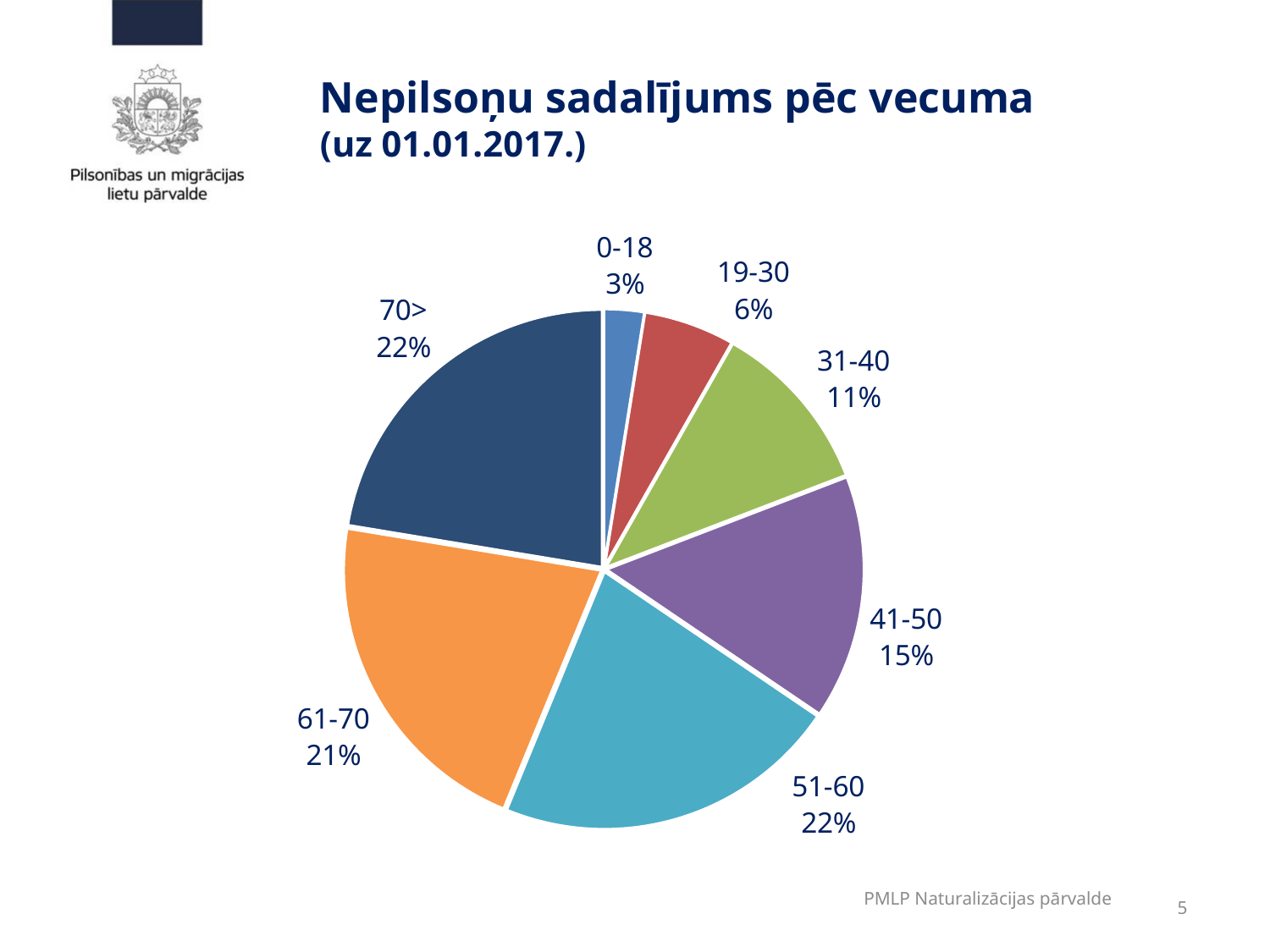
Which has a larger share, the 41-50 age group or the 31-40 age group? 41-50 What share of the pie does the 0-18 age group have? 3% How many slices does the pie chart have? 7 What kind of chart is shown on the slide? pie chart Which has a larger share, the 61-70 age group or the 19-30 age group? 61-70 What is the difference in percentage points between the 51-60 and 19-30 age groups? 16 What share of the pie does the 41-50 age group have? 15% What is the title of the chart? Nepilsoņu sadalījums pēc vecuma (uz 01.01.2017.) What share of the pie does the 61-70 age group have? 21% What share of the pie does the 31-40 age group have? 11% Which age group has the smallest share of the pie? 0-18 What is the combined share of the 0-18 and 19-30 age groups? 9%